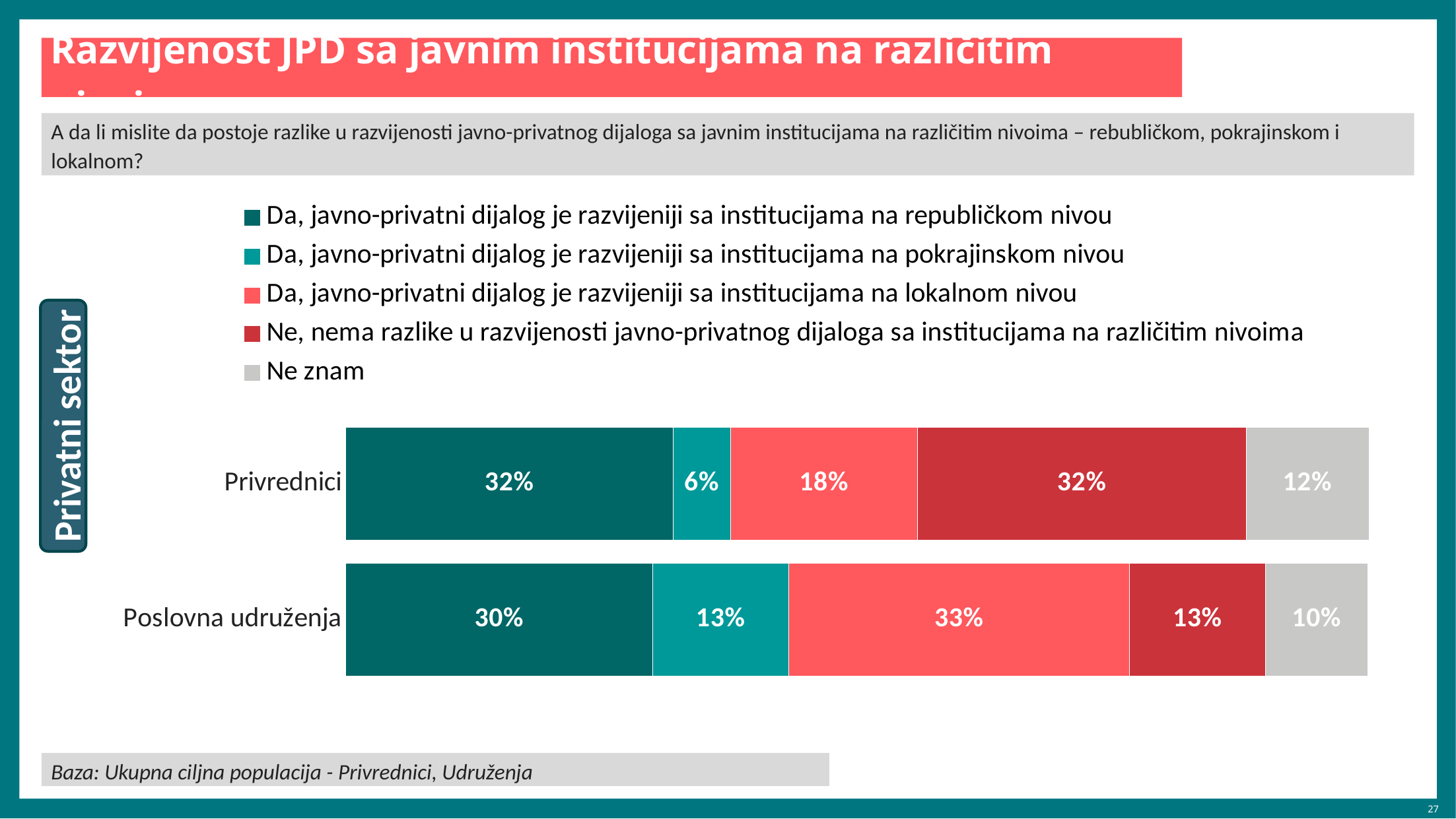
What is the difference between the "lokalnom nivou" values for Poslovna udruženja and Privrednici? 15 percentage points How many series does the legend list? 5 What is the "Ne znam" value for Privrednici? 12% What percentage of Privrednici said public-private dialogue is more developed with institutions at the republic level ("Da, javno-privatni dijalog je razvijeniji sa institucijama na republičkom nivou")? 32% What kind of chart is shown on the slide? Stacked bar chart Which series has the lowest value for Privrednici? Da, javno-privatni dijalog je razvijeniji sa institucijama na pokrajinskom nivou How many categories are shown on the chart? 2 Which category has the higher value for "Ne, nema razlike u razvijenosti javno-privatnog dijaloga sa institucijama na različitim nivoima", Privrednici or Poslovna udruženja? Privrednici What is the value for Poslovna udruženja in the "Da, javno-privatni dijalog je razvijeniji sa institucijama na pokrajinskom nivou" series? 13% What is the value for Privrednici in the "Ne, nema razlike u razvijenosti javno-privatnog dijaloga sa institucijama na različitim nivoima" series? 32% What is the difference between the "pokrajinskom nivou" values for Poslovna udruženja and Privrednici? 7 percentage points What is the value for Poslovna udruženja in the "Da, javno-privatni dijalog je razvijeniji sa institucijama na lokalnom nivou" series? 33%